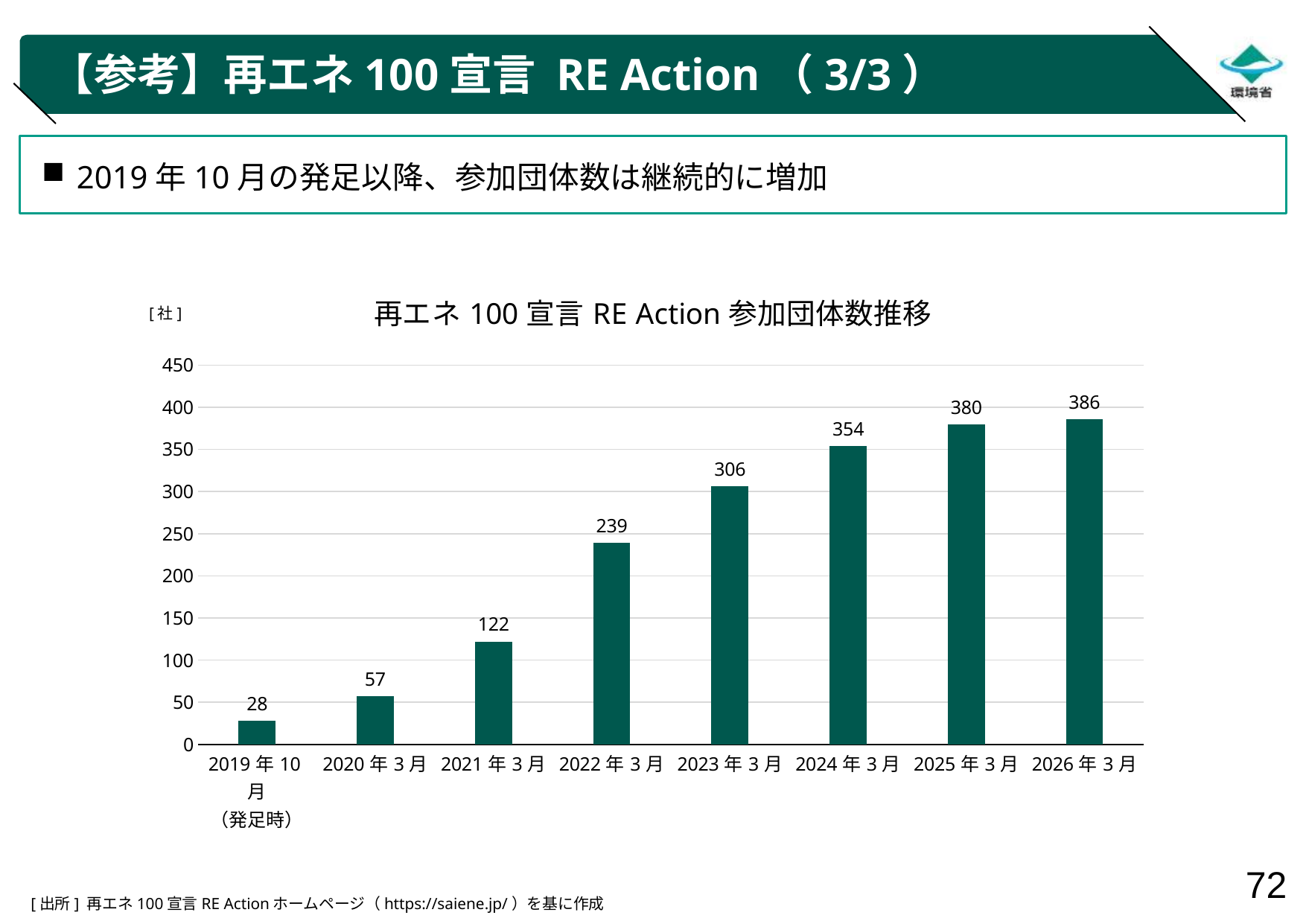
Do the values rise or fall from 2019年10月 to 2026年3月? rise Is the value for 2022年3月 greater or less than 250? less Which period has the lowest value on the chart? 2019年10月 (発足時) What is the value shown for 2019年10月 (発足時)? 28 What kind of chart is shown on the slide? bar chart What is the value for 2021年3月? 122 What is the number of participating organizations in 2023年3月? 306 Which is larger, the value for 2024年3月 or the value for 2023年3月? 2024年3月 How many time periods are shown on the x axis? 8 Which period has the highest number of participating organizations? 2026年3月 What is the difference between the values for 2022年3月 and 2020年3月? 182 What is the difference between the values for 2026年3月 and 2025年3月? 6